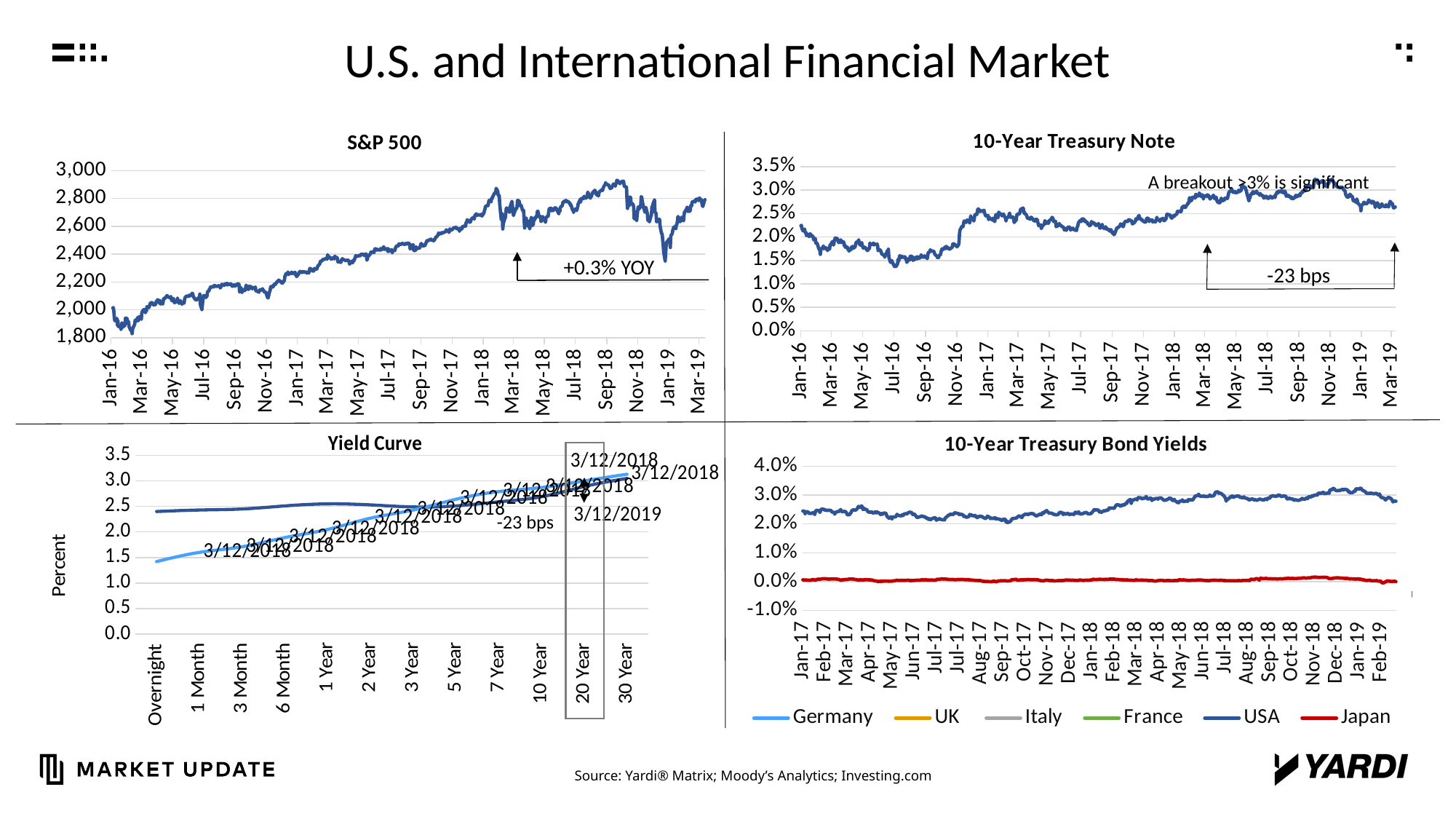
On the 10-Year Treasury Bond Yields chart, how many countries does the legend list? 6 On the S&P 500 chart, does the index generally rise or fall from Jan-16 to Mar-19? rise On the 10-Year Treasury Note chart, what change in basis points is annotated? -23 bps On the 10-Year Treasury Bond Yields chart, which has the higher yield in Feb-19, USA or Japan? USA On the S&P 500 chart, is the value in Mar-19 greater or less than 2,600? greater On the 10-Year Treasury Note chart, what breakout level is noted as significant? >3% On the Yield Curve chart, how many maturity categories are shown on the x axis? 12 On the Yield Curve chart, which two dates are plotted? 3/12/2018 and 3/12/2019 On the S&P 500 chart, is the value in Jan-16 greater or less than 2,200? less What kind of chart is the S&P 500 chart? line chart On the S&P 500 chart, what year-over-year change is annotated? +0.3% YOY On the 10-Year Treasury Note chart, is the value in Jul-16 greater or less than 2.0%? less